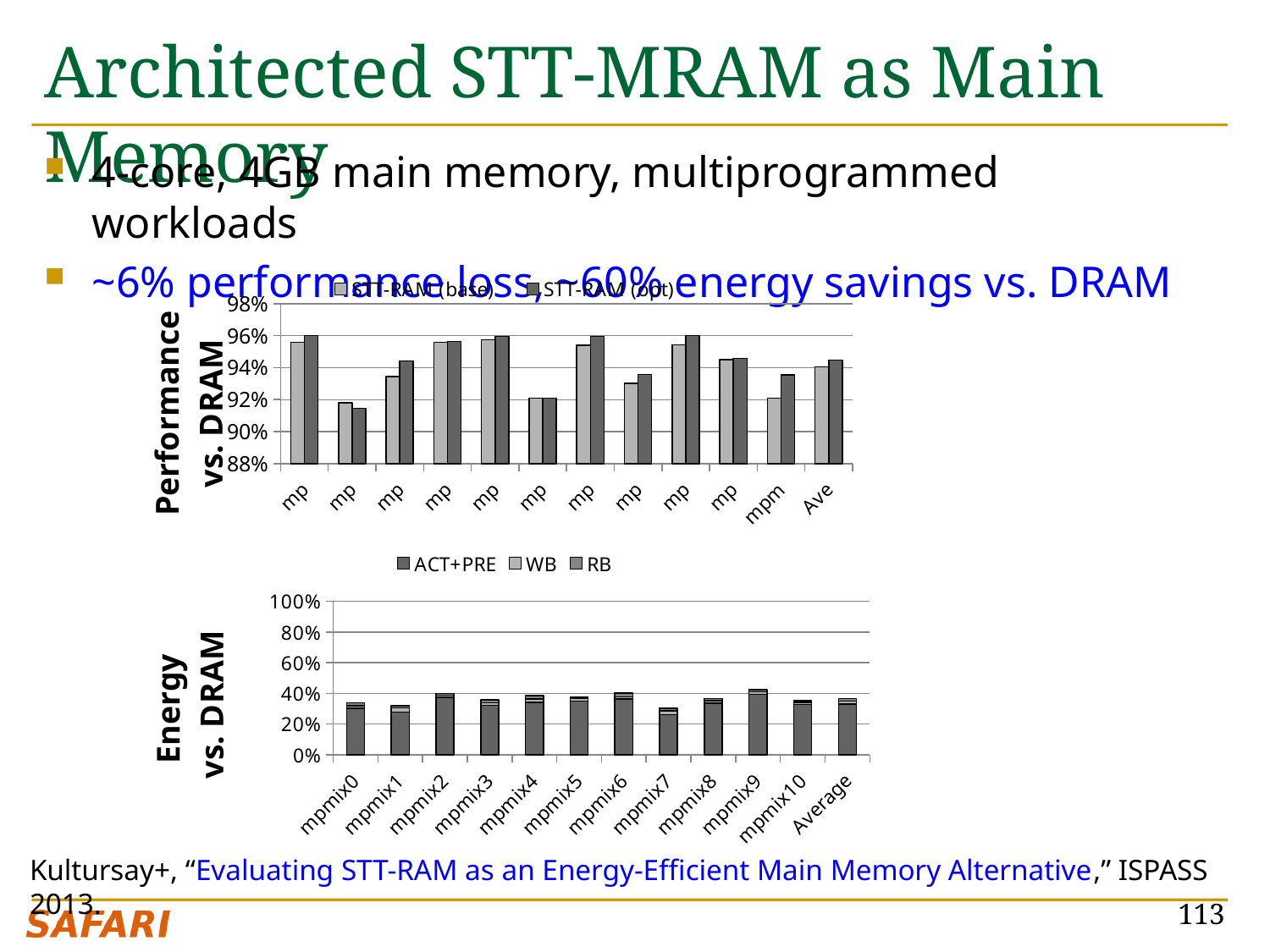
In the bottom chart (Energy vs. DRAM), how many categories are shown on the x axis? 12 What kind of chart is the top chart (Performance vs. DRAM)? bar chart In the top chart (Performance vs. DRAM), is the STT-RAM (opt) value for Ave greater or less than 92%? greater In the bottom chart (Energy vs. DRAM), is the total for mpmix7 greater or less than 40%? less What is the y-axis label of the top chart? Performance vs. DRAM In the top chart (Performance vs. DRAM), how many series does the legend list? 2 In the bottom chart (Energy vs. DRAM), what are the legend entries? ACT+PRE, WB, RB In the bottom chart (Energy vs. DRAM), is the total for mpmix9 greater or less than 20%? greater What kind of chart is the bottom chart (Energy vs. DRAM)? stacked bar chart In the bottom chart (Energy vs. DRAM), how many series does the legend list? 3 In the bottom chart (Energy vs. DRAM), which has the larger total, mpmix9 or mpmix7? mpmix9